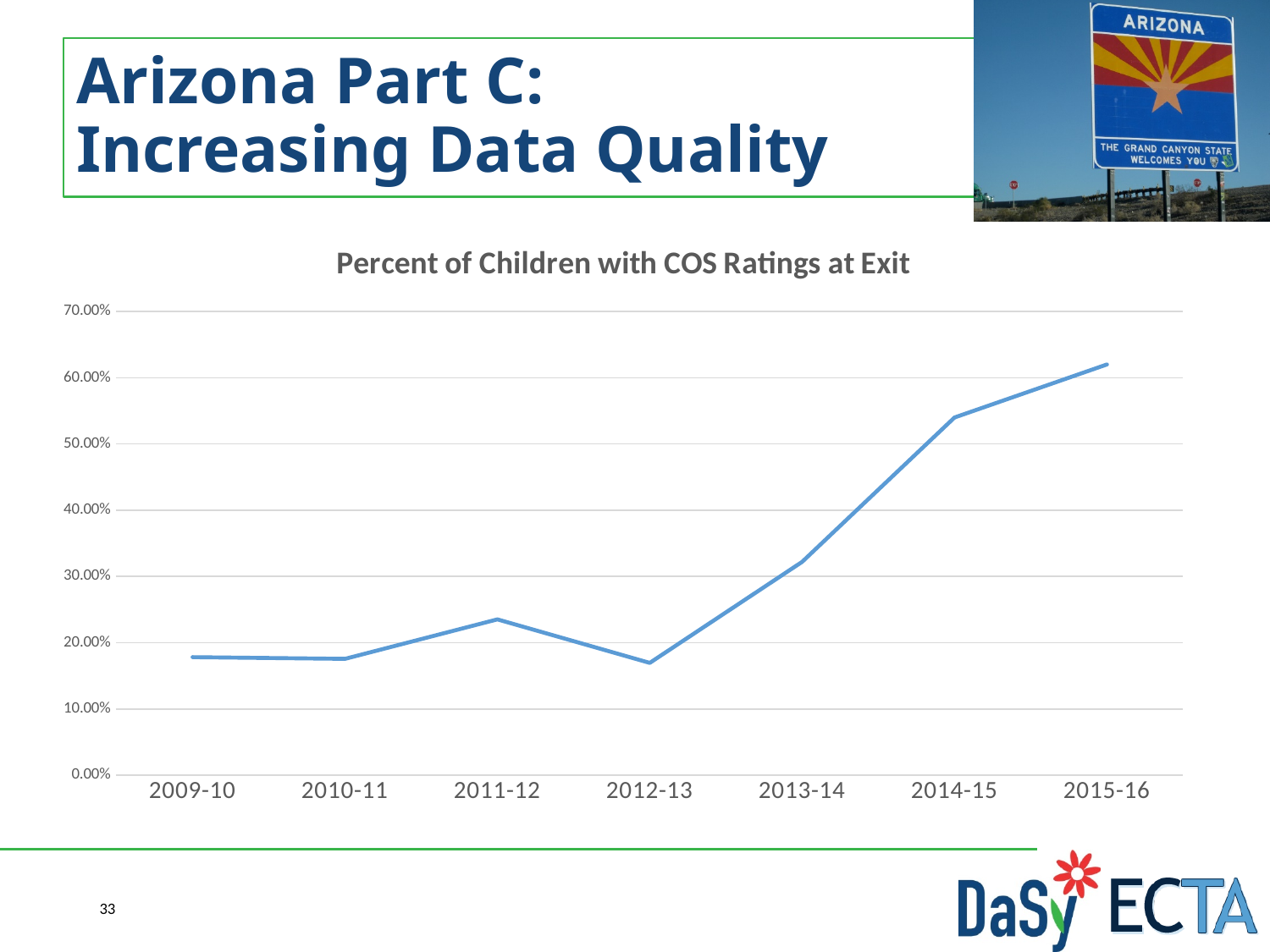
How many school years are plotted on the x axis? 7 What kind of chart is shown on the slide? line chart Is the value for 2013-14 greater or less than 40.00%? less Is the value for 2011-12 greater or less than 20.00%? greater Which school year has the highest percent of children with COS ratings at exit? 2015-16 Is the value for 2014-15 greater or less than 50.00%? greater Which is larger, the value for 2013-14 or the value for 2014-15? 2014-15 Which is larger, the value for 2011-12 or the value for 2012-13? 2011-12 What is the title of the chart? Percent of Children with COS Ratings at Exit Does the percent of children with COS ratings at exit generally rise or fall from 2012-13 to 2015-16? rise